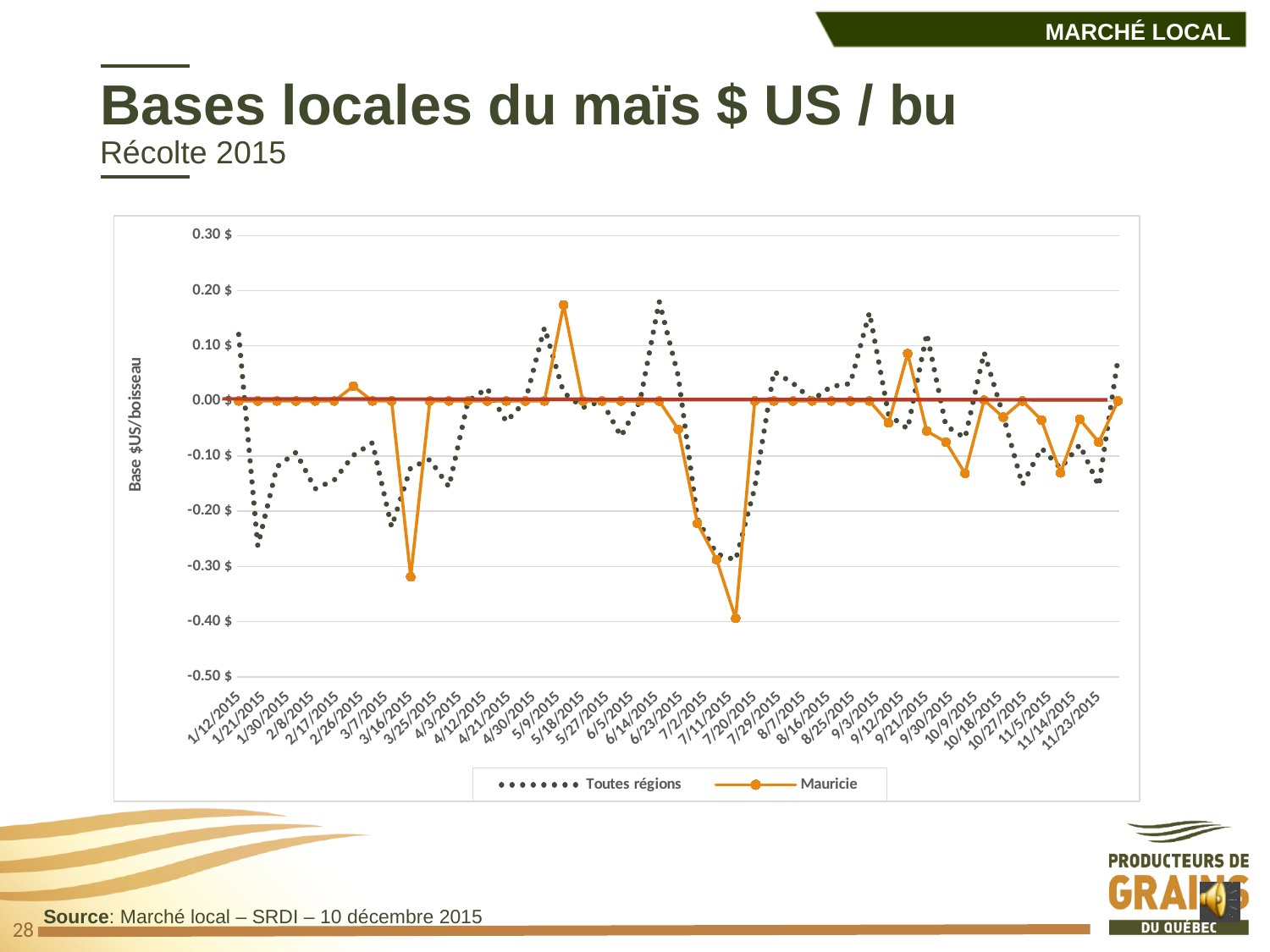
On which date does the Mauricie series reach its highest value? 5/9/2015 Is the Mauricie value on 7/11/2015 greater or less than -0.30 $? less On 3/25/2015, which series has the lower value, Toutes régions or Mauricie? Mauricie How many series does the chart legend list? 2 On 7/11/2015, which series has the higher value, Toutes régions or Mauricie? Toutes régions What is the label on the vertical axis of the chart? Base $US/boisseau Is the Toutes régions value on 1/21/2015 greater or less than -0.20 $? less Is the Toutes régions value on 6/14/2015 greater or less than 0.10 $? greater On which date does the Mauricie series reach its lowest value? 7/11/2015 What kind of chart is shown on the slide? line chart What are the two series named in the chart legend? Toutes régions and Mauricie